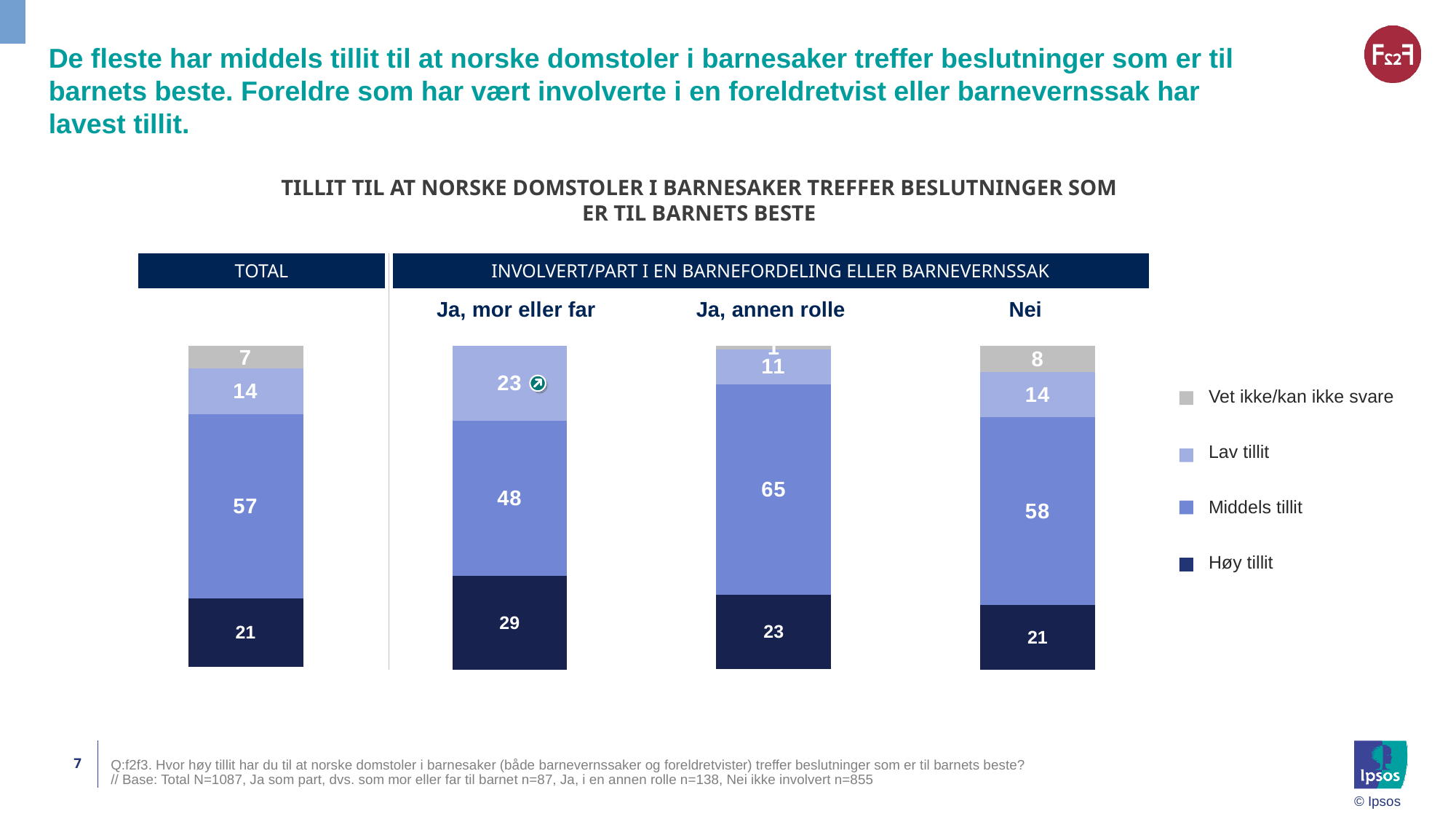
What is the value for Middels tillit in the TOTAL bar? 57 Which has the larger Høy tillit value, 'Ja, annen rolle' or 'Nei'? Ja, annen rolle Which group has the highest value for Høy tillit? Ja, mor eller far What is the value for Vet ikke/kan ikke svare in the 'Nei' bar? 8 What kind of chart is shown on the slide? Stacked bar chart Which group has the highest value for Middels tillit? Ja, annen rolle How many series does the legend list? 4 What is the value for Høy tillit in the 'Ja, mor eller far' bar? 29 How many bars (groups) are shown in the chart? 4 What is the value for Middels tillit in the 'Ja, annen rolle' bar? 65 What is the value for Lav tillit in the 'Nei' bar? 14 What is the difference between the Lav tillit value for 'Ja, mor eller far' and for 'Nei'? 9